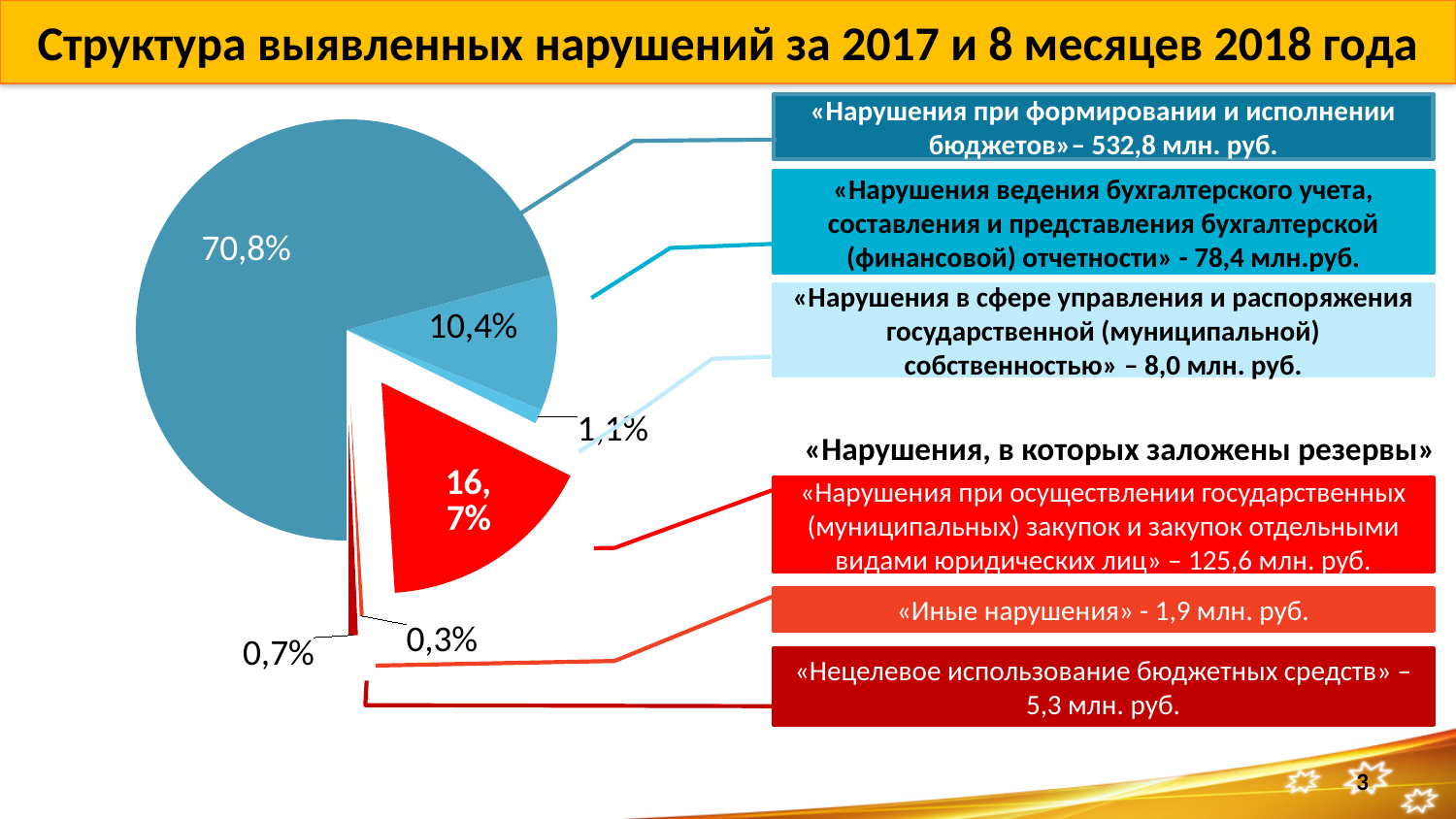
Which is larger: the share for «Нецелевое использование бюджетных средств» or the share for «Иные нарушения»? «Нецелевое использование бюджетных средств» (0,7%) What share of the pie corresponds to «Нарушения при осуществлении государственных (муниципальных) закупок и закупок отдельными видами юридических лиц»? 16,7% What amount in млн. руб. is given for «Нарушения в сфере управления и распоряжения государственной (муниципальной) собственностью»? 8,0 млн. руб. What is the difference in percentage points between the largest slice (70,8%) and the red 16,7% slice? 54,1 What share of the pie is labelled for «Нарушения при формировании и исполнении бюджетов»? 70,8% What amount in млн. руб. is given for «Нарушения при формировании и исполнении бюджетов»? 532,8 млн. руб. What percentage is shown for «Нарушения ведения бухгалтерского учета, составления и представления бухгалтерской (финансовой) отчетности»? 10,4% What is the title of the slide? Структура выявленных нарушений за 2017 и 8 месяцев 2018 года Which slice of the pie chart is the largest? «Нарушения при формировании и исполнении бюджетов» (70,8%) Which slice of the pie chart is the smallest? «Иные нарушения» (0,3%) What kind of chart is shown on the slide? Pie chart How many slices does the pie chart have? 6